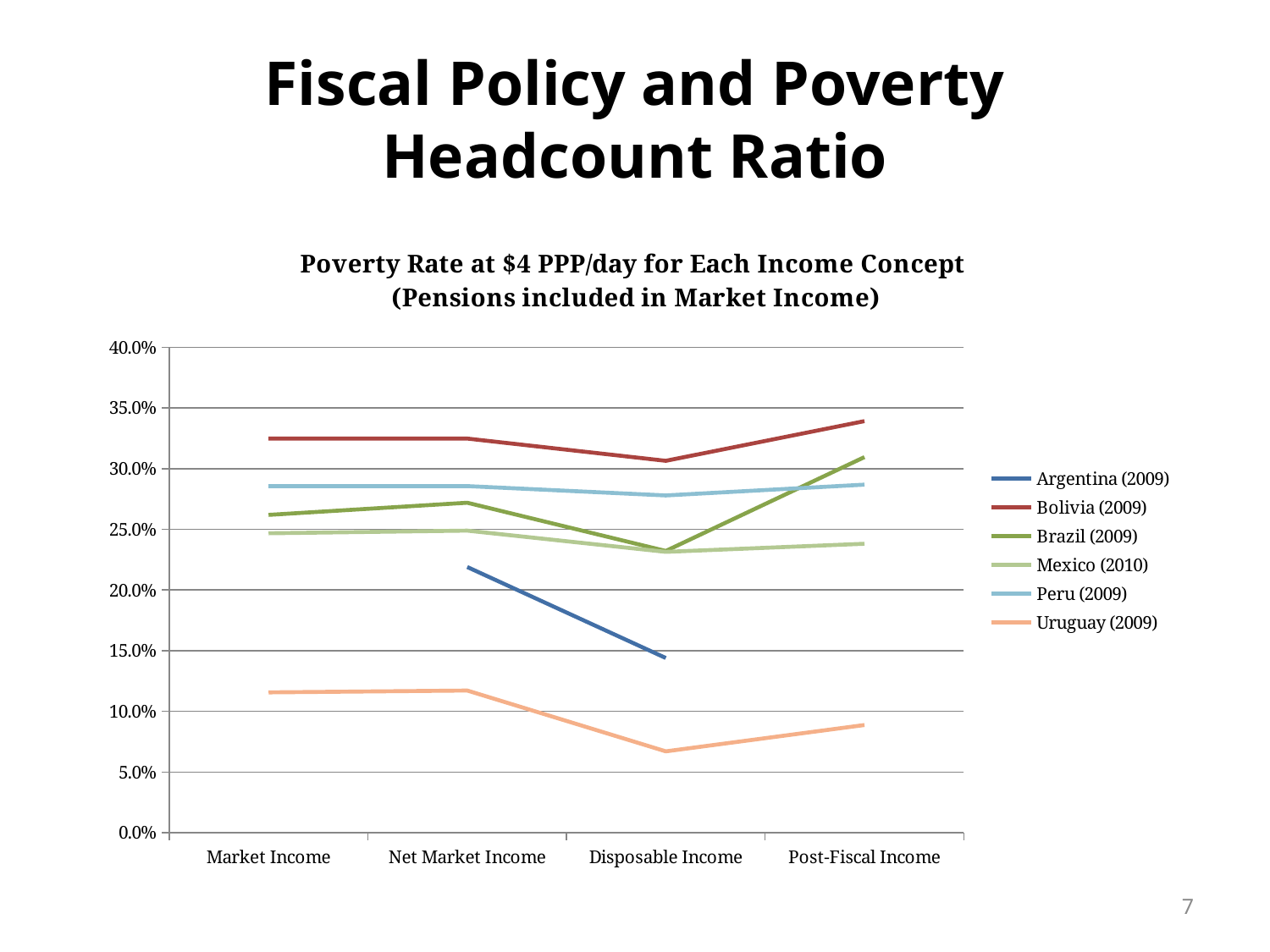
Does the line for Uruguay (2009) rise or fall from Disposable Income to Post-Fiscal Income? rise Does the line for Argentina (2009) rise or fall from Net Market Income to Disposable Income? fall What kind of chart is shown on the slide? line chart Which country has the highest poverty rate at Market Income? Bolivia (2009) What is the title of the chart? Poverty Rate at $4 PPP/day for Each Income Concept (Pensions included in Market Income) How many income concepts are shown along the x axis? 4 Is the value for Uruguay (2009) at Disposable Income greater or less than 10.0%? less Is the value for Argentina (2009) at Disposable Income greater or less than 20.0%? less How many series does the legend list? 6 Which country has the lowest poverty rate at Disposable Income? Uruguay (2009) Is the value for Bolivia (2009) at Post-Fiscal Income greater or less than 30.0%? greater At Post-Fiscal Income, which is larger: the value for Brazil (2009) or Peru (2009)? Brazil (2009)